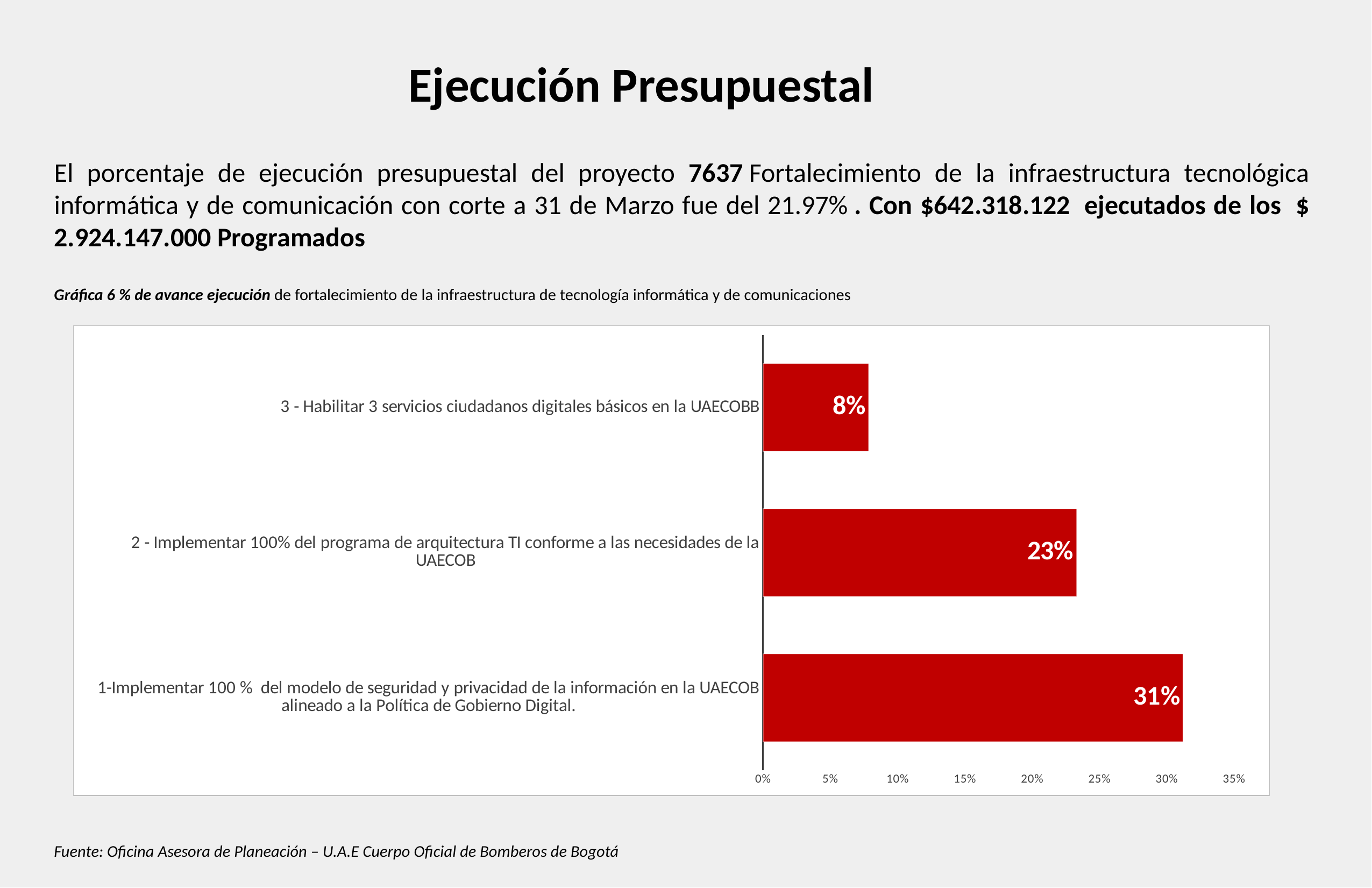
Which category has the highest value? 1-Implementar 100 % del modelo de seguridad y privacidad de la información en la UAECOB alineado a la Política de Gobierno Digital. What is the difference between the value for goal 2 (programa de arquitectura TI) and goal 3 (servicios ciudadanos digitales)? 15% What is the difference between the value for goal 1 (modelo de seguridad y privacidad) and goal 2 (programa de arquitectura TI)? 8% What is the maximum value shown on the horizontal axis of the chart? 35% Is the value for goal 1 (modelo de seguridad y privacidad) greater or less than 30%? greater What is the value for '3 - Habilitar 3 servicios ciudadanos digitales básicos en la UAECOBB'? 8% What is the value for '1-Implementar 100 % del modelo de seguridad y privacidad de la información en la UAECOB alineado a la Política de Gobierno Digital.'? 31% Which category has the lowest value? 3 - Habilitar 3 servicios ciudadanos digitales básicos en la UAECOBB What is the value for '2 - Implementar 100% del programa de arquitectura TI conforme a las necesidades de la UAECOB'? 23% How many categories are shown in the chart? 3 What kind of chart is shown on the slide? Bar chart Which is larger: the value for goal 2 (programa de arquitectura TI) or goal 3 (servicios ciudadanos digitales)? 2 - Implementar 100% del programa de arquitectura TI conforme a las necesidades de la UAECOB